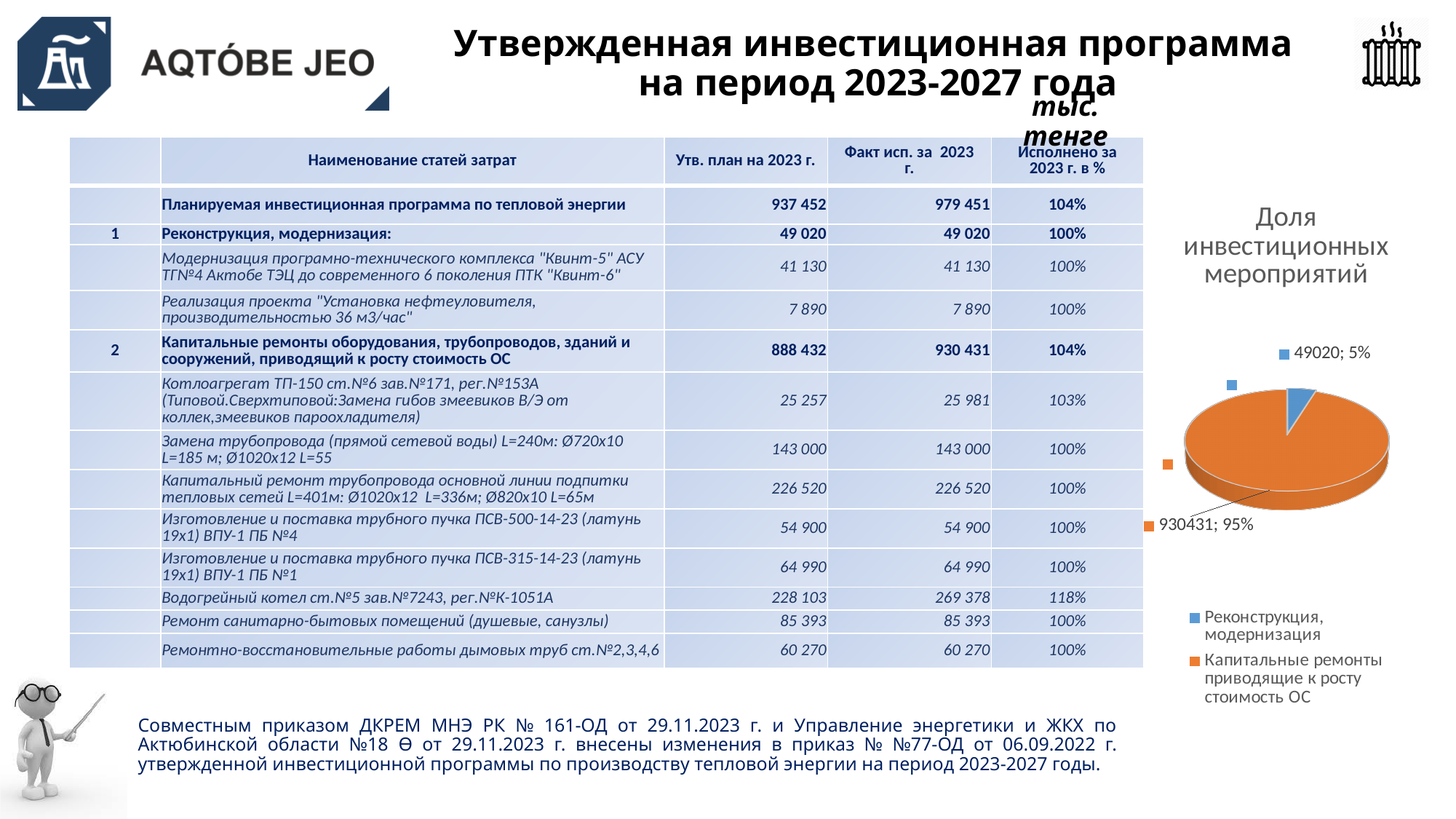
What is the title of the pie chart? Доля инвестиционных мероприятий Which slice of the pie chart is the smallest? Реконструкция, модернизация What value is labelled for the slice "Реконструкция, модернизация" in the pie chart? 49020 How many slices does the pie chart have? 2 How many entries does the pie chart legend list? 2 Which slice of the pie chart is the largest? Капитальные ремонты приводящие к росту стоимость ОС Which is larger in the pie chart: "Реконструкция, модернизация" or "Капитальные ремонты приводящие к росту стоимость ОС"? Капитальные ремонты приводящие к росту стоимость ОС What share of the pie does "Реконструкция, модернизация" represent? 5% What kind of chart is shown on the slide? pie chart What colour is the "Реконструкция, модернизация" slice in the pie chart? blue What share of the pie does "Капитальные ремонты приводящие к росту стоимость ОС" represent? 95% What value is labelled for the slice "Капитальные ремонты приводящие к росту стоимость ОС" in the pie chart? 930431